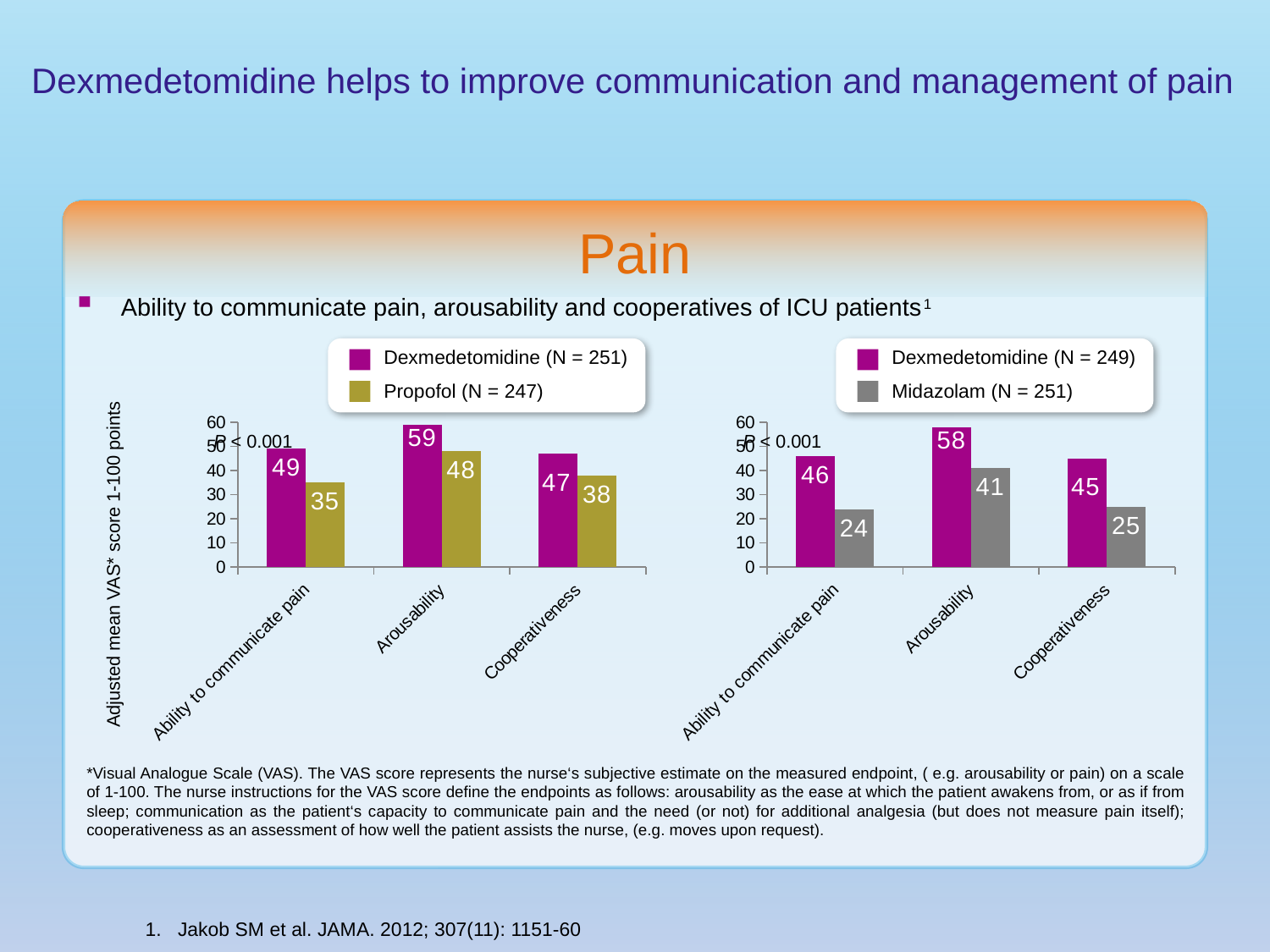
In the right chart (Dexmedetomidine vs Midazolam), what is the value for Midazolam for Ability to communicate pain? 24 In the right chart (Dexmedetomidine vs Midazolam), which is larger for Arousability: Dexmedetomidine or Midazolam? Dexmedetomidine In the left chart (Dexmedetomidine vs Propofol), what is the value for Propofol for Ability to communicate pain? 35 What type of chart is the left chart (Dexmedetomidine vs Propofol)? Bar chart How many series does the legend of the right chart (Dexmedetomidine vs Midazolam) list? 2 In the right chart (Dexmedetomidine vs Midazolam), what is the value for Dexmedetomidine for Cooperativeness? 45 How many categories are shown on the x axis of the left chart (Dexmedetomidine vs Propofol)? 3 In the left chart (Dexmedetomidine vs Propofol), which category has the highest Dexmedetomidine value? Arousability In the left chart (Dexmedetomidine vs Propofol), what is the value for Dexmedetomidine for Arousability? 59 In the right chart (Dexmedetomidine vs Midazolam), which category has the lowest Midazolam value? Ability to communicate pain In the left chart (Dexmedetomidine vs Propofol), what is the difference between the Dexmedetomidine and Propofol values for Ability to communicate pain? 14 In the right chart (Dexmedetomidine vs Midazolam), what is the difference between the Dexmedetomidine and Midazolam values for Cooperativeness? 20